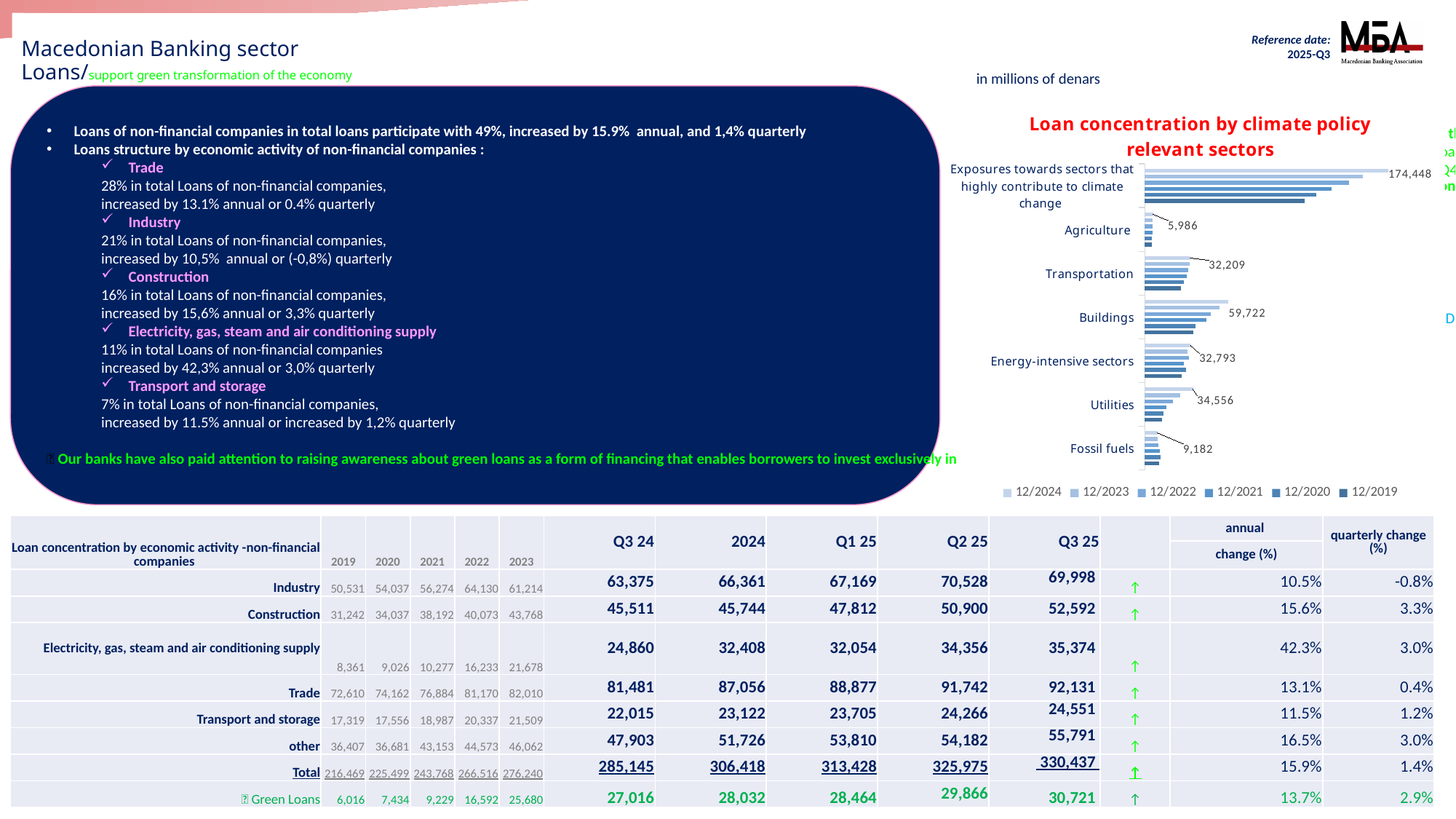
What type of chart is 'Loan concentration by climate policy relevant sectors'? bar chart In the 'Loan concentration by climate policy relevant sectors' chart, which has the larger labelled 12/2024 value, Buildings or Energy-intensive sectors? Buildings In the 'Loan concentration by climate policy relevant sectors' chart, what is the labelled 12/2024 value for 'Exposures towards sectors that highly contribute to climate change'? 174,448 In the 'Loan concentration by climate policy relevant sectors' chart, which category has the highest labelled 12/2024 value? Exposures towards sectors that highly contribute to climate change In the 'Loan concentration by climate policy relevant sectors' chart, what is the labelled 12/2024 value for Fossil fuels? 9,182 In the 'Loan concentration by climate policy relevant sectors' chart, what is the difference between the labelled 12/2024 values for Utilities and Transportation? 2,347 Which legend entry is listed first in the 'Loan concentration by climate policy relevant sectors' chart? 12/2024 In the 'Loan concentration by climate policy relevant sectors' chart, what is the labelled 12/2024 value for Buildings? 59,722 In the 'Loan concentration by climate policy relevant sectors' chart, what is the labelled 12/2024 value for Agriculture? 5,986 In the 'Loan concentration by climate policy relevant sectors' chart, which category has the lowest labelled 12/2024 value? Agriculture How many series does the legend of the 'Loan concentration by climate policy relevant sectors' chart list? 6 How many categories are shown on the 'Loan concentration by climate policy relevant sectors' chart? 7